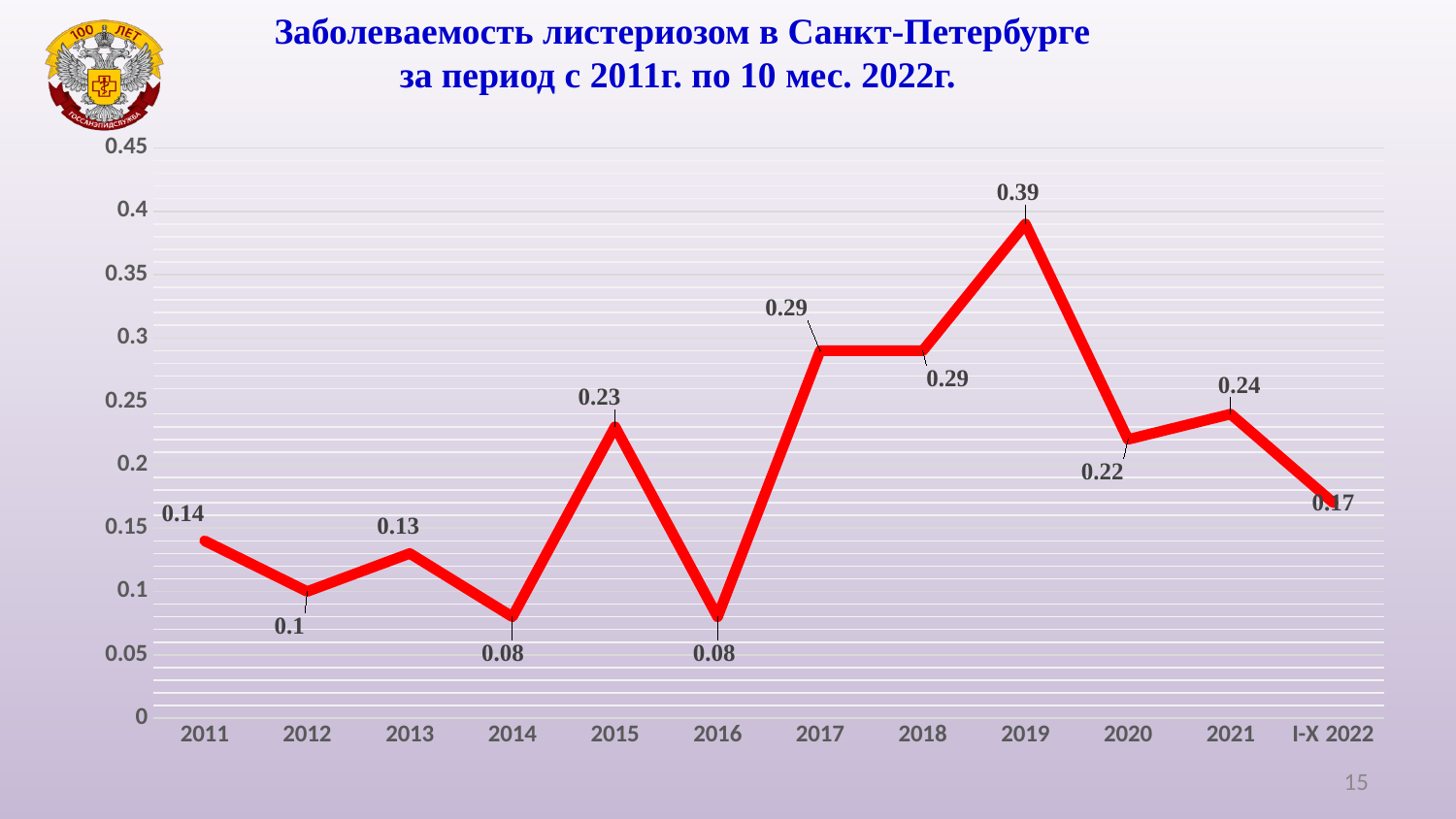
What is the difference between the values for 2019 and 2020? 0.17 Does the value rise or fall from 2019 to 2020? fall What type of chart is shown on the slide? line chart What is the value plotted for 2015? 0.23 Is the value for 2017 greater or less than 0.25? greater Which year has the highest value on the chart? 2019 How many time periods are plotted along the x axis? 12 Which years share the lowest value on the chart? 2014 and 2016 What is the listeriosis incidence value for 2019? 0.39 What is the title of the chart? Заболеваемость листериозом в Санкт-Петербурге за период с 2011г. по 10 мес. 2022г. Which is larger, the value for 2011 or the value for 2013? 2011 What is the value plotted for 2021? 0.24